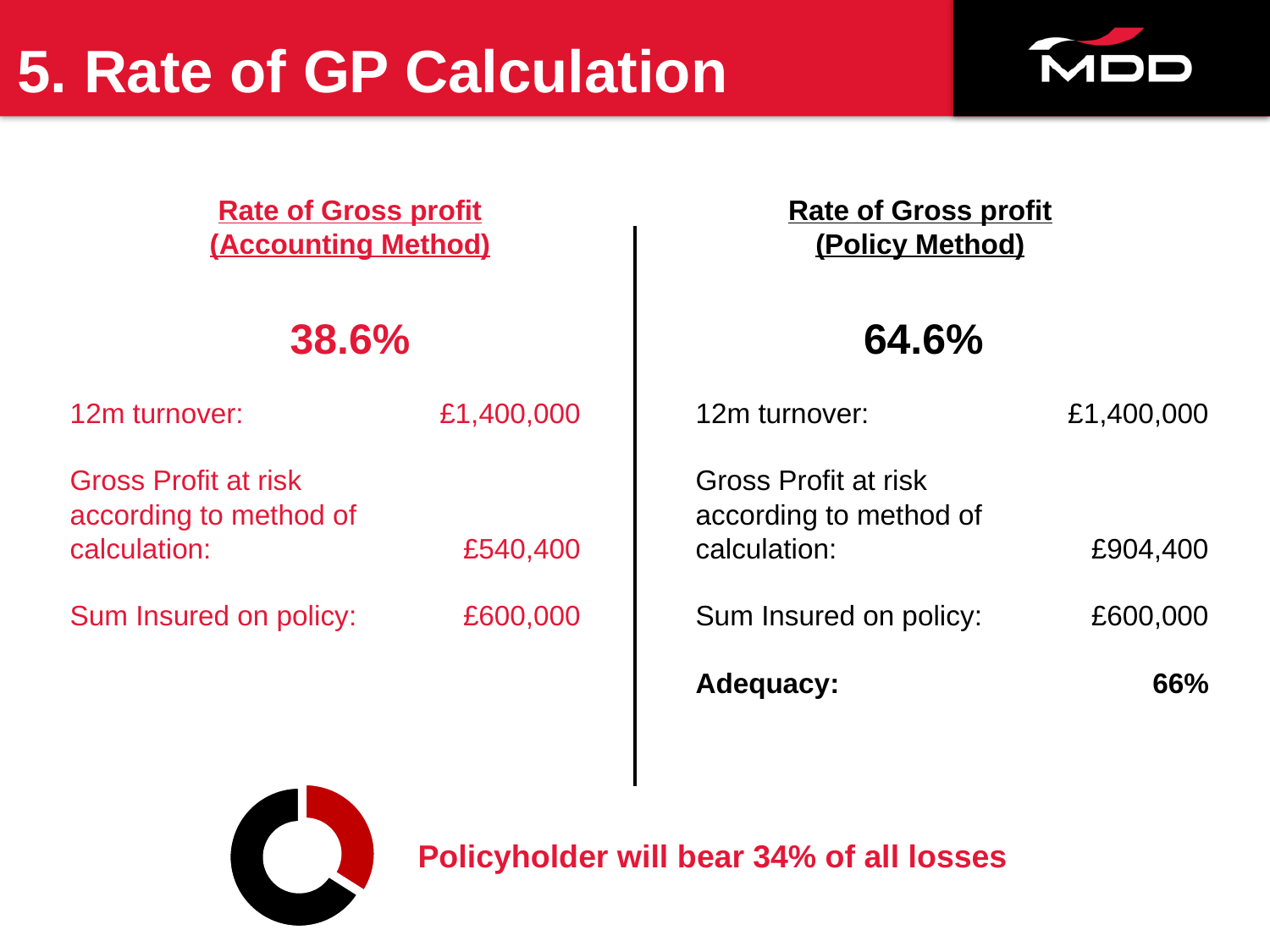
Does the doughnut chart at the bottom left of the slide have a legend? No What kind of chart is shown at the bottom left of the slide? Doughnut (pie) chart What two colours are used for the slices of the doughnut chart at the bottom left of the slide? Red and black How many slices does the doughnut chart at the bottom left of the slide have? 2 In the doughnut chart at the bottom left, is the red slice more or less than half of the chart? Less In the doughnut chart at the bottom left, which slice is larger, the red one or the black one? The black one